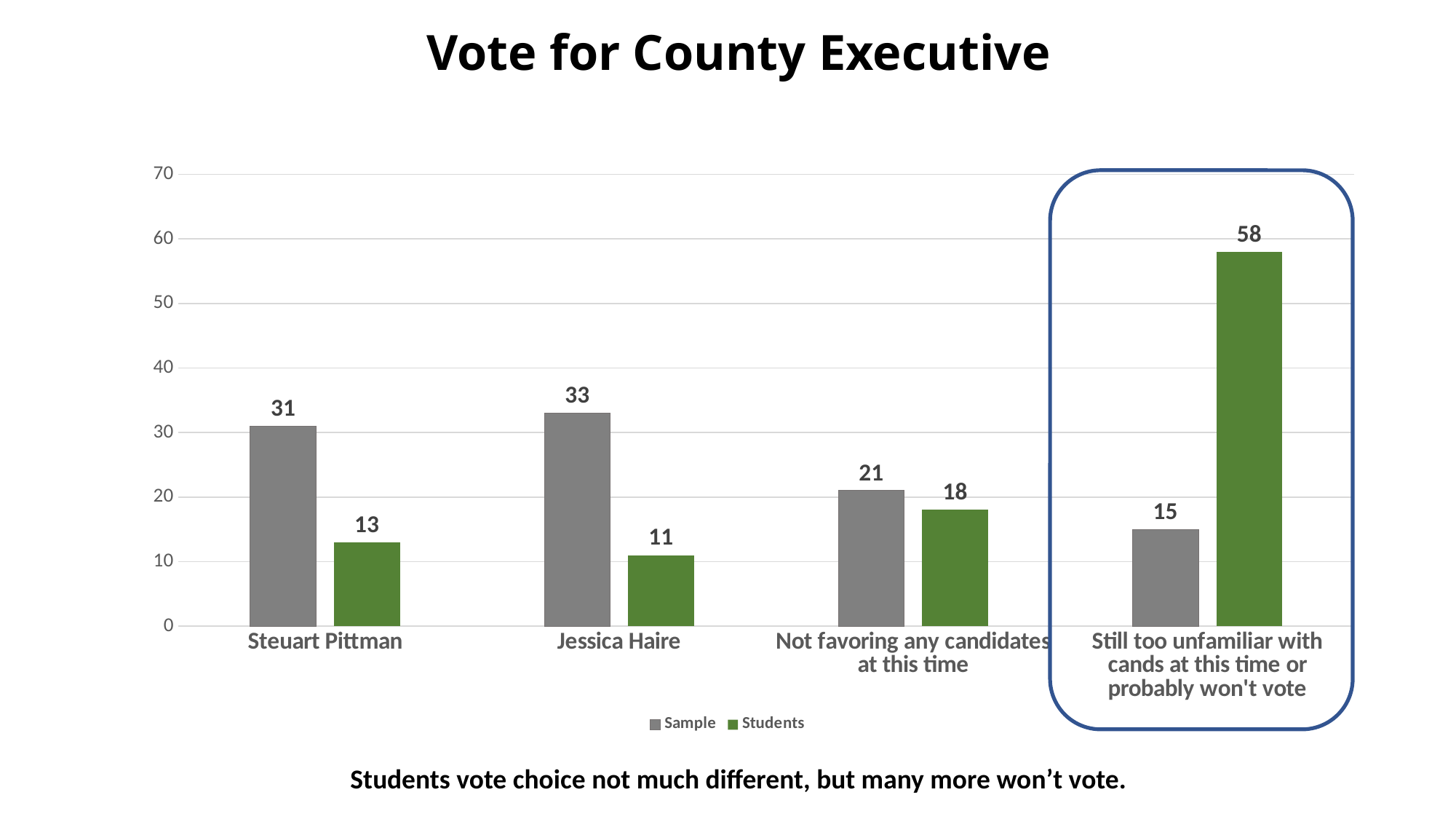
Which category has the highest Students value? Still too unfamiliar with cands at this time or probably won't vote What is the title of the chart? Vote for County Executive What kind of chart is shown on the slide? Bar chart Is the Students value for 'Still too unfamiliar with cands at this time or probably won't vote' greater or less than 50? greater For 'Not favoring any candidates at this time', which is larger, the Sample value or the Students value? Sample What is the Students value for 'Still too unfamiliar with cands at this time or probably won't vote'? 58 What is the Students value for Jessica Haire? 11 How many series does the legend list? 2 What is the difference between the Sample and Students values for Jessica Haire? 22 What is the Sample value for Steuart Pittman? 31 Which category has the lowest Sample value? Still too unfamiliar with cands at this time or probably won't vote How many categories are shown on the x axis? 4